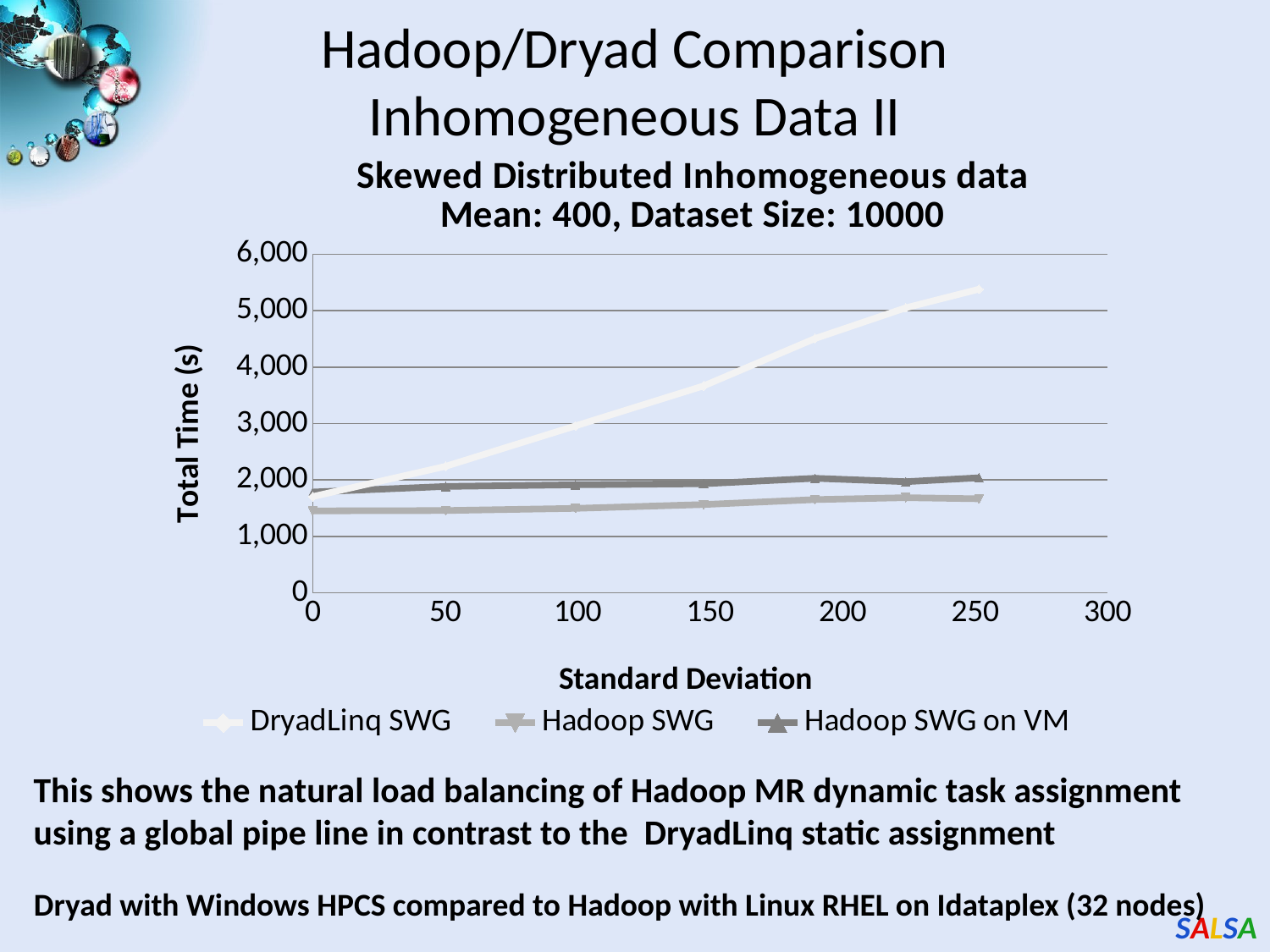
What is the title of the chart? Skewed Distributed Inhomogeneous data Mean: 400, Dataset Size: 10000 Is the value for DryadLinq SWG at standard deviation 150 greater or less than 3,000? greater At standard deviation 200, which is larger: DryadLinq SWG or Hadoop SWG on VM? DryadLinq SWG Which series has the lowest total time at standard deviation 250? Hadoop SWG Is the value for Hadoop SWG at standard deviation 0 greater or less than 2,000? less What kind of chart is shown on the slide? line chart Which series has the highest total time at standard deviation 250? DryadLinq SWG Does the DryadLinq SWG total time rise or fall as standard deviation increases? rise How many series does the legend list? 3 Is the value for DryadLinq SWG at standard deviation 250 greater or less than 5,000? greater What is the label of the y axis? Total Time (s)